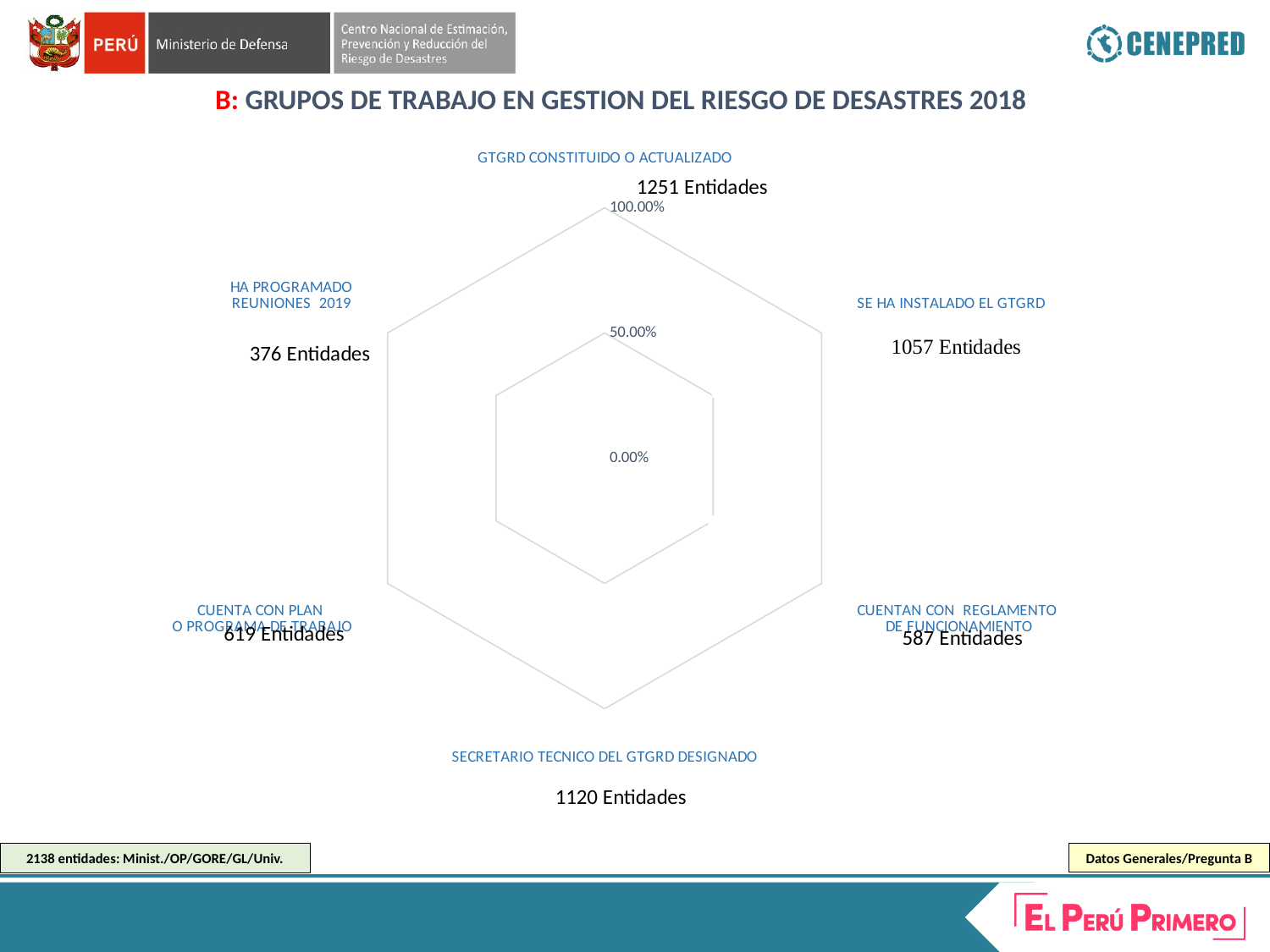
How many entities are shown for GTGRD CONSTITUIDO O ACTUALIZADO? 1251 Entidades How many categories does the chart have? 6 How many entities are shown for CUENTAN CON REGLAMENTO DE FUNCIONAMIENTO? 587 Entidades What kind of chart is shown on the slide? Radar chart How many entities are shown for SE HA INSTALADO EL GTGRD? 1057 Entidades What is the difference in entities between GTGRD CONSTITUIDO O ACTUALIZADO and SE HA INSTALADO EL GTGRD? 194 Which has more entities: CUENTA CON PLAN O PROGRAMA DE TRABAJO or CUENTAN CON REGLAMENTO DE FUNCIONAMIENTO? CUENTA CON PLAN O PROGRAMA DE TRABAJO What is the title of the slide's chart section? B: GRUPOS DE TRABAJO EN GESTION DEL RIESGO DE DESASTRES 2018 How many entities are shown for SECRETARIO TECNICO DEL GTGRD DESIGNADO? 1120 Entidades How many entities are shown for HA PROGRAMADO REUNIONES 2019? 376 Entidades Which category has the lowest number of entities? HA PROGRAMADO REUNIONES 2019 Which category has the highest number of entities? GTGRD CONSTITUIDO O ACTUALIZADO